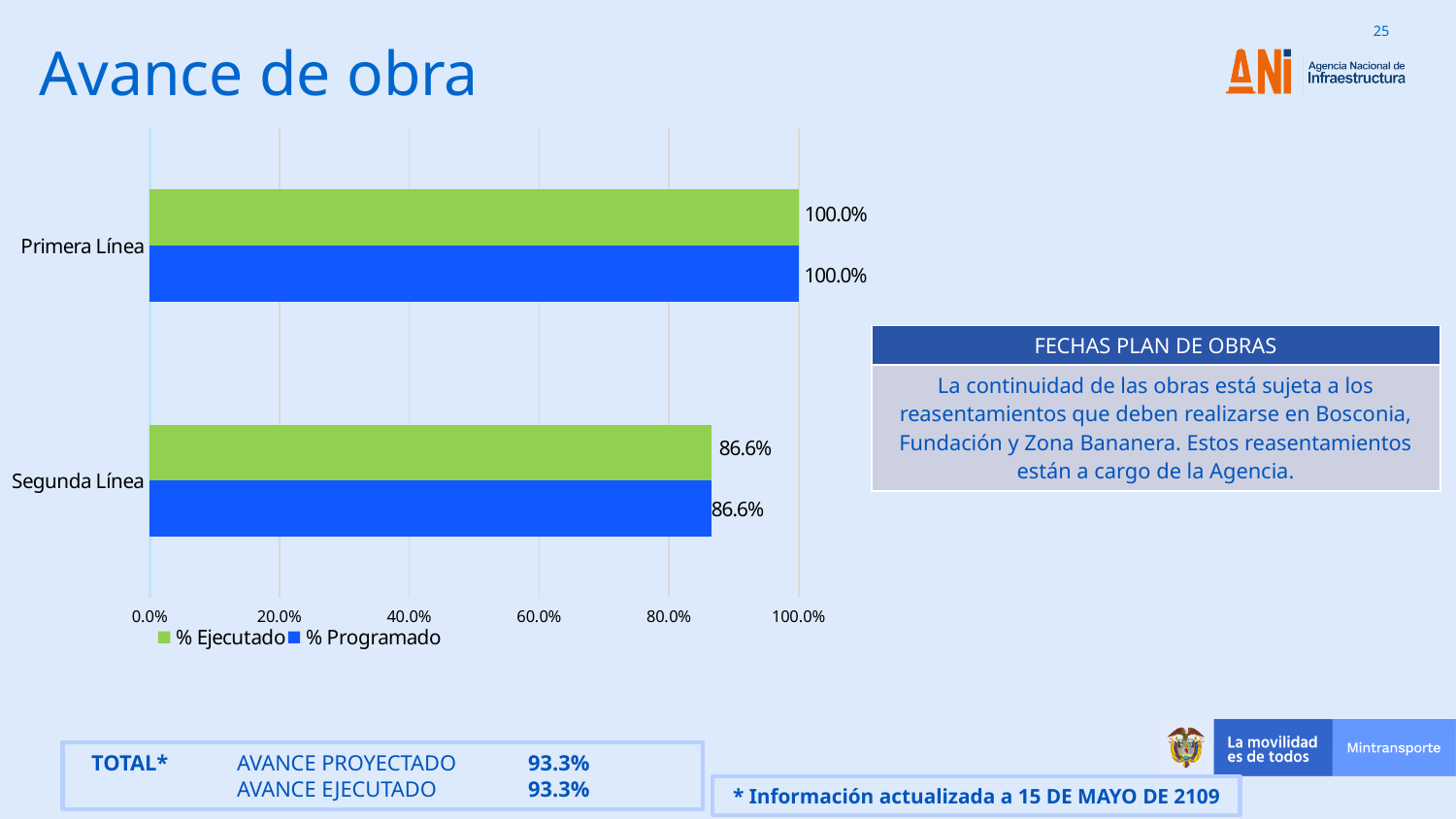
What kind of chart is shown on the slide? Bar chart How many categories are shown on the chart? 2 What is the difference between the % Ejecutado values for Primera Línea and Segunda Línea? 13.4% Is the % Ejecutado value for Segunda Línea greater or less than 80.0%? greater How many series does the legend list? 2 Which is larger: the % Programado value for Primera Línea or for Segunda Línea? Primera Línea Which category has the highest % Ejecutado value? Primera Línea Which colour represents the % Programado series? Blue Which category has the lowest % Programado value? Segunda Línea What is the % Ejecutado value for Primera Línea? 100.0% What is the % Ejecutado value for Segunda Línea? 86.6% What is the % Programado value for Segunda Línea? 86.6%